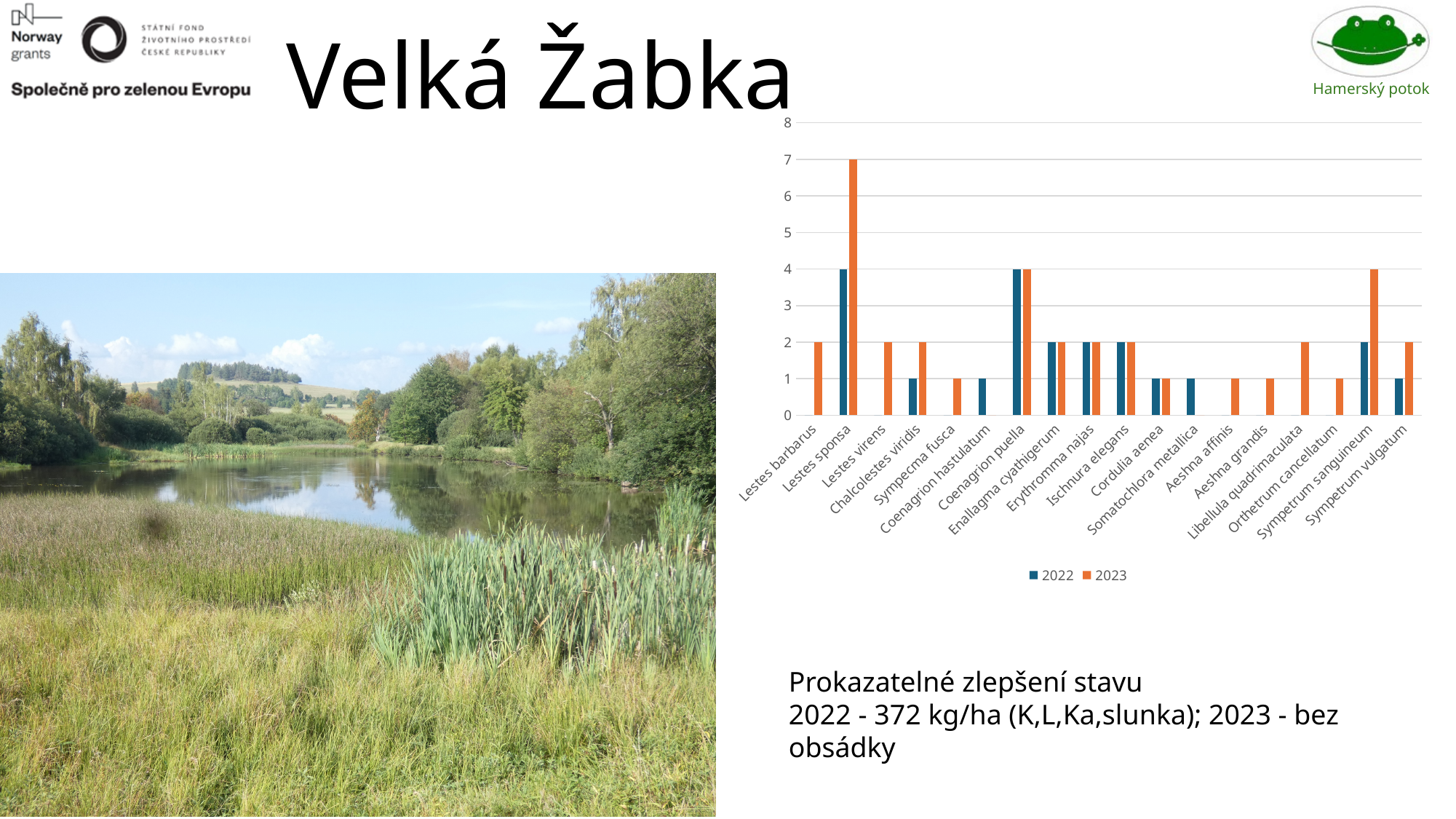
What is the 2023 value for Sympetrum sanguineum? 4 What is the difference between the 2023 and 2022 values for Sympetrum sanguineum? 2 Which species has the highest 2023 value? Lestes sponsa What is the 2023 value for Lestes sponsa? 7 How many series does the chart legend list? 2 Is the 2023 value for Lestes sponsa greater or less than 5? greater What is the 2022 value for Lestes sponsa? 4 Which series are listed in the chart legend? 2022 and 2023 What is the 2022 value for Coenagrion puella? 4 Which is larger for Lestes sponsa, the 2022 value or the 2023 value? 2023 How many species categories are shown on the x axis of the chart? 18 What kind of chart is shown on the slide? bar chart